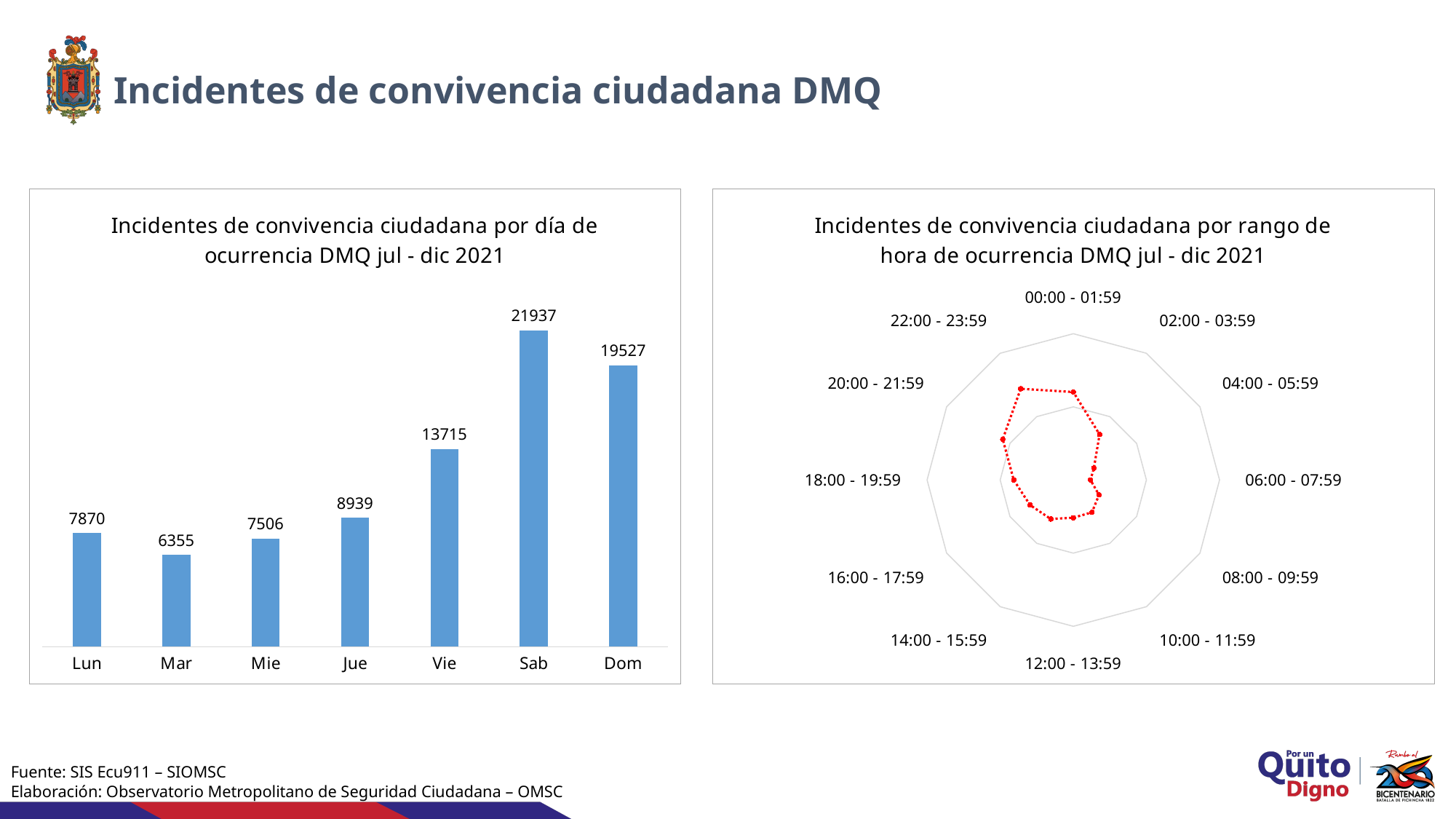
What kind of chart is the chart on the right? radar chart How many time ranges are shown in the radar chart on the right? 12 In the bar chart on the left, which day has the lowest number of incidents? Mar In the bar chart on the left, which is larger, the value for Lun or the value for Mie? Lun In the bar chart on the left, how many incidents occurred on Sab? 21937 What kind of chart is the chart on the left? bar chart How many days are shown in the bar chart on the left? 7 In the bar chart on the left, what is the value for Mie? 7506 In the bar chart on the left, do the values rise or fall from Mar to Sab? rise In the bar chart on the left, what is the difference between the values for Sab and Dom? 2410 In the bar chart on the left, which day has the highest number of incidents? Sab In the bar chart on the left, what is the difference between the values for Vie and Jue? 4776